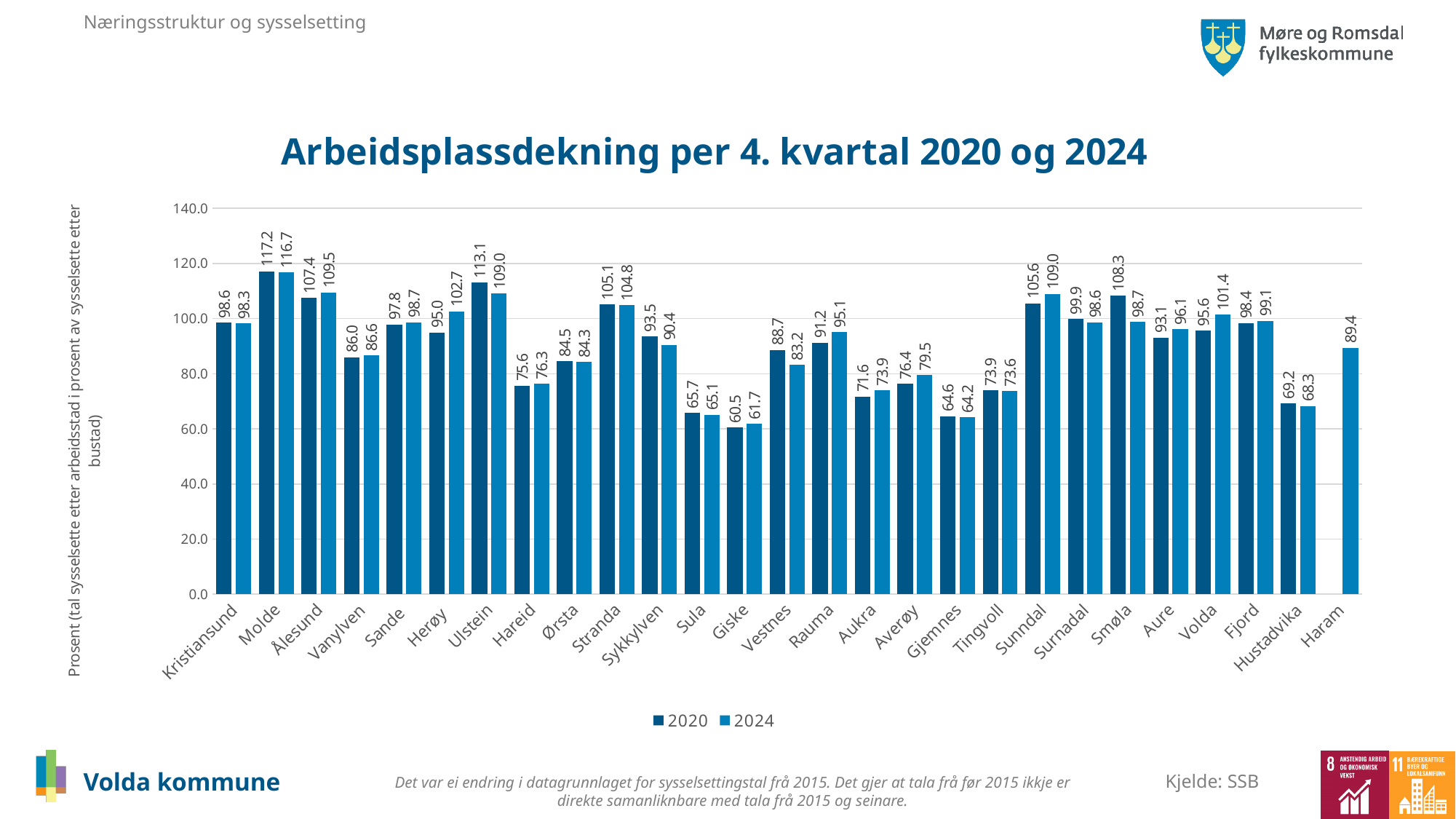
What is the difference between the 2020 and 2024 values for Smøla? 9.6 Is the 2020 value for Sunndal greater or less than 100.0? greater Which municipality has the highest 2020 value? Molde What is the 2024 value for Volda? 101.4 What is the 2020 value for Ulstein? 113.1 What is the difference between the 2024 and 2020 values for Volda? 5.8 How many municipalities are shown on the x axis? 27 How many series does the legend list? 2 Which municipality has the lowest 2024 value? Giske What is the 2024 value for Haram? 89.4 Which is larger for Herøy: the 2020 value or the 2024 value? 2024 What type of chart is shown? Bar chart